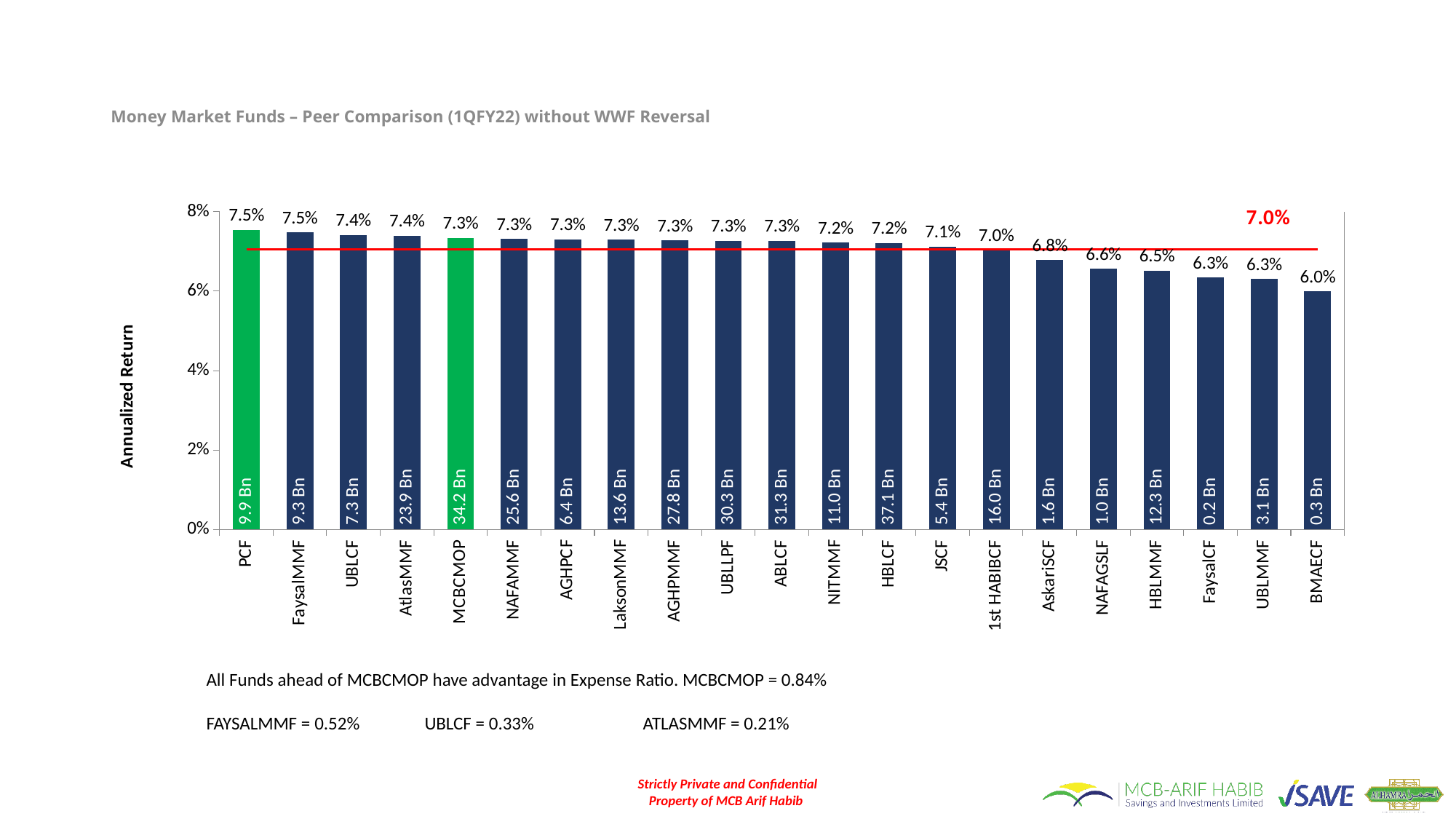
What is the annualized return shown for AskariSCF? 6.8% Which has the higher annualized return, UBLCF or HBLMMF? UBLCF What fund size label is printed inside the HBLCF bar? 37.1 Bn What is the annualized return shown for MCBCMOP? 7.3% What is the annualized return shown for BMAECF? 6.0% Is the annualized return for FaysalCF greater or less than 7%? less Do the annualized returns rise or fall moving from left to right along the x axis? Fall How many funds are plotted on the chart? 21 What kind of chart is shown on the slide? Bar chart Which fund has the lowest annualized return on the chart? BMAECF What value is labelled on the red horizontal line across the chart? 7.0% What is the difference between the annualized return of PCF and that of BMAECF? 1.5%